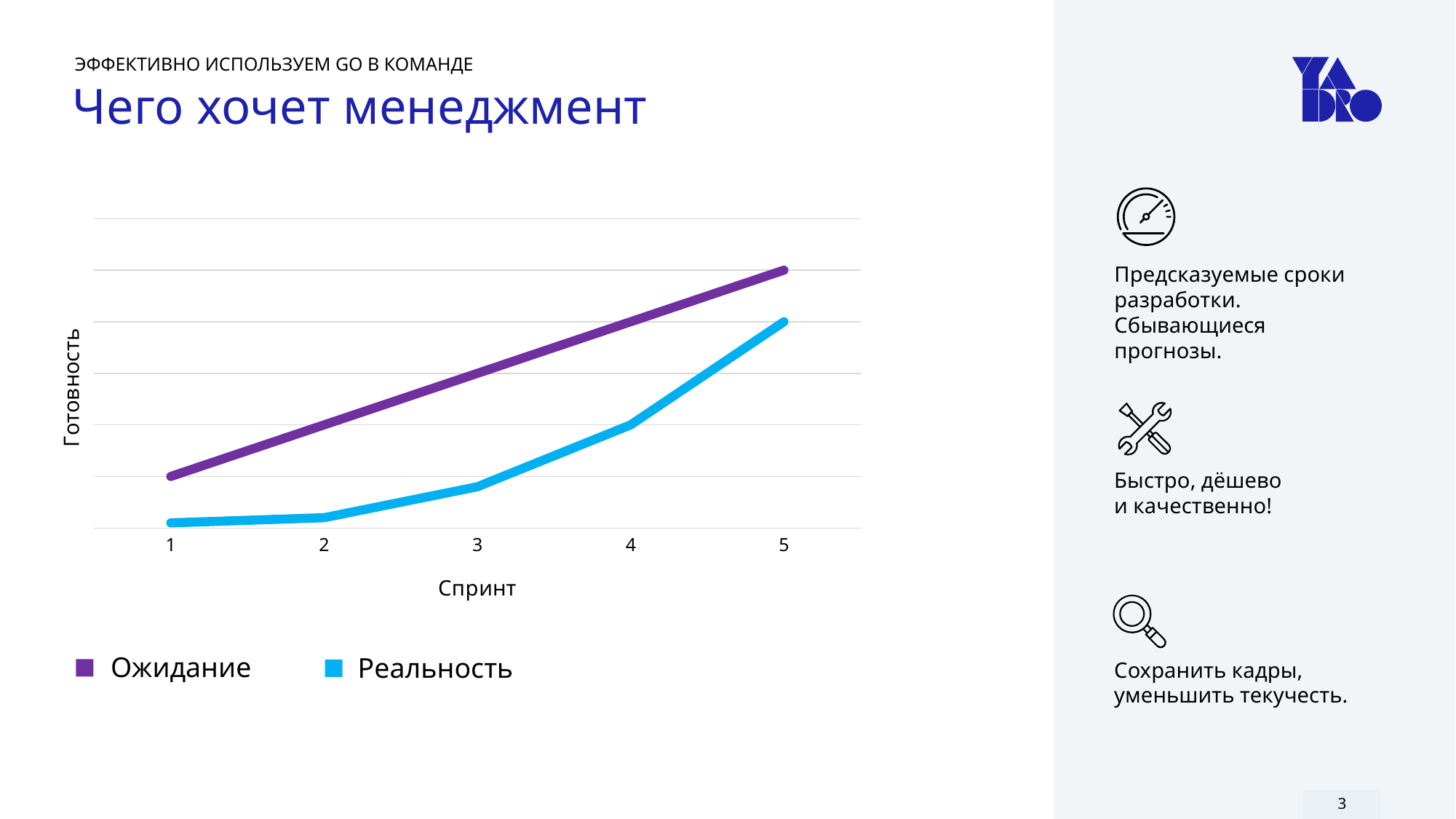
What kind of chart is shown on the slide? line chart At sprint 5, which series has the higher value, Ожидание or Реальность? Ожидание Does the Реальность line rise or fall from sprint 1 to sprint 5? rise Does the Ожидание line rise or fall from sprint 1 to sprint 5? rise At sprint 3, which series has the higher value, Ожидание or Реальность? Ожидание At which sprint is the Ожидание series at its lowest value? 1 How many series does the chart legend list? 2 What is the label of the y axis? Готовность At which sprint does the Реальность series reach its highest value? 5 How many sprints are plotted along the x axis? 5 What is the label of the x axis? Спринт